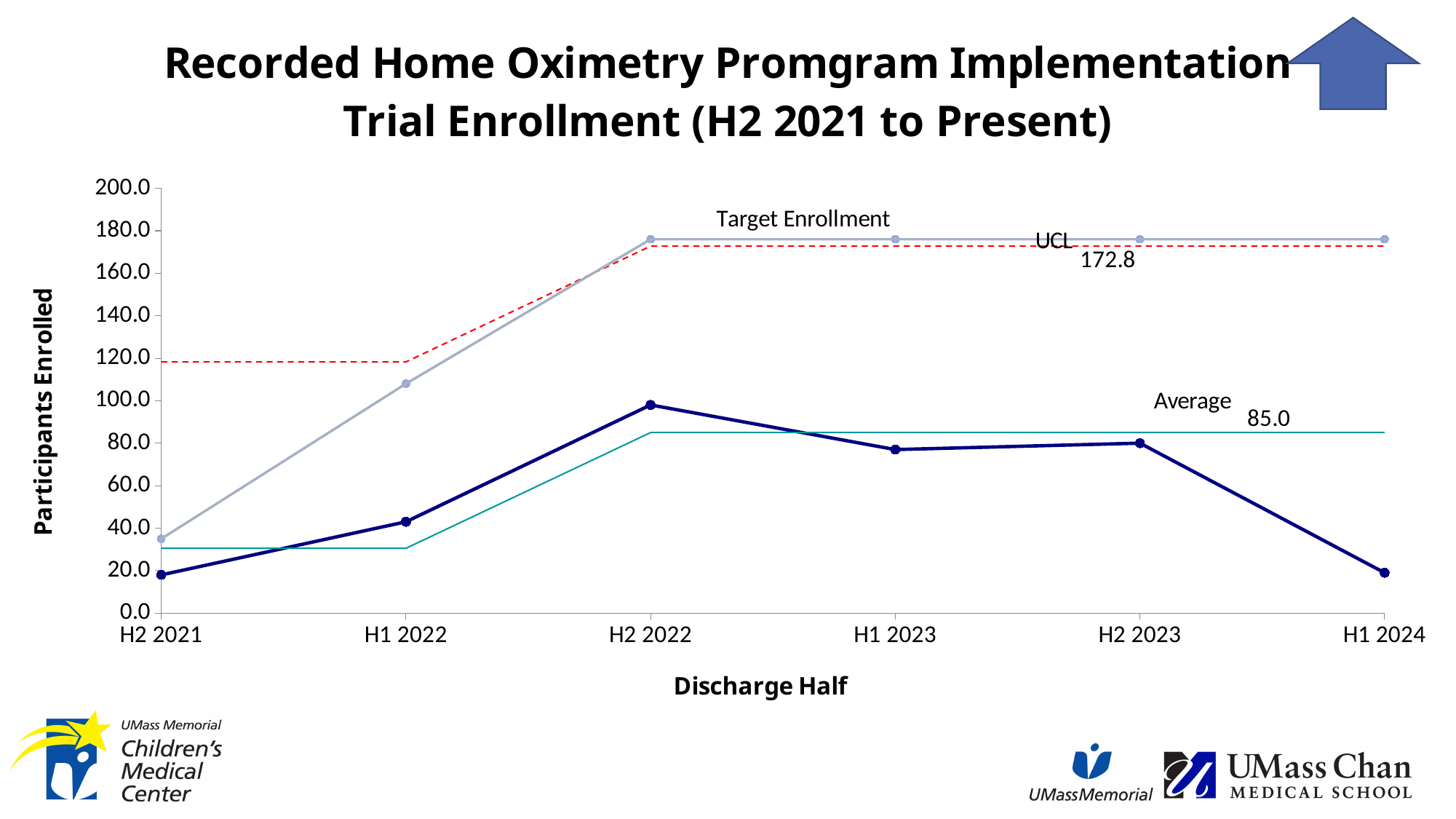
What kind of chart is shown on the slide? line chart Did the number of participants enrolled rise or fall from H2 2023 to H1 2024? fall What value is labelled for the UCL line? 172.8 In which discharge half was the number of participants enrolled highest? H2 2022 Did the number of participants enrolled rise or fall from H2 2021 to H2 2022? rise How many discharge halves are shown on the x axis? 6 Is the number of participants enrolled in H1 2024 greater or less than 40? less What value is labelled for the Average line? 85.0 Which discharge half had more participants enrolled, H1 2022 or H2 2023? H2 2023 What is the title of the x axis? Discharge Half Is the number of participants enrolled in H2 2022 greater or less than 80? greater Is the Target Enrollment value for H1 2022 greater or less than 100? greater